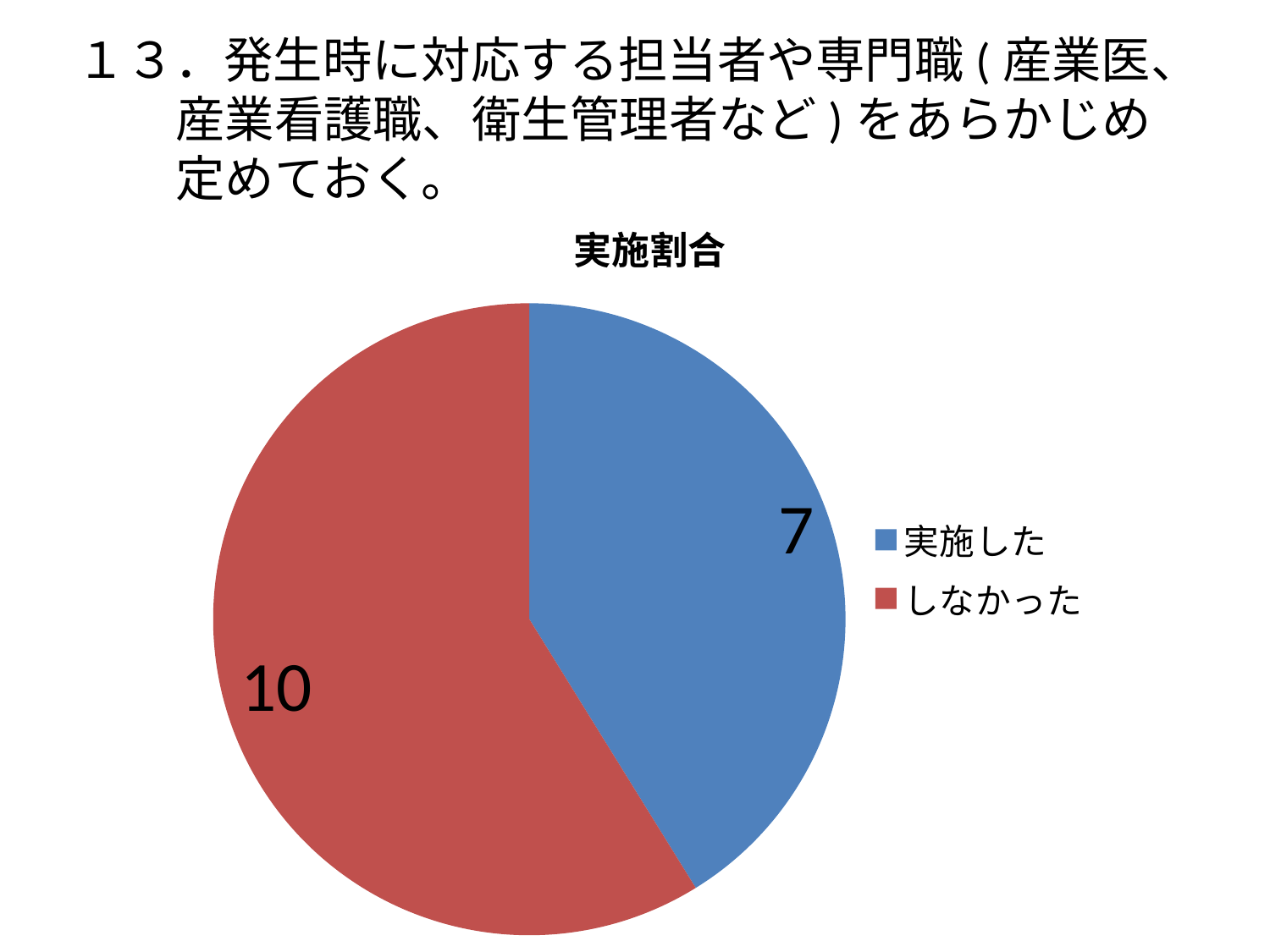
What is the chart's title? 実施割合 How many categories does the pie chart have? 2 Which is larger, the value for 実施した or the value for しなかった? しなかった What is the value for しなかった? 10 Which category has the largest slice? しなかった What type of chart is shown on the slide? pie chart What is the difference between the values for しなかった and 実施した? 3 How many entries does the legend list? 2 What colour is the slice for しなかった? red What is the value for 実施した? 7 Which category has the smallest slice? 実施した What is the total of all slices in the pie chart? 17